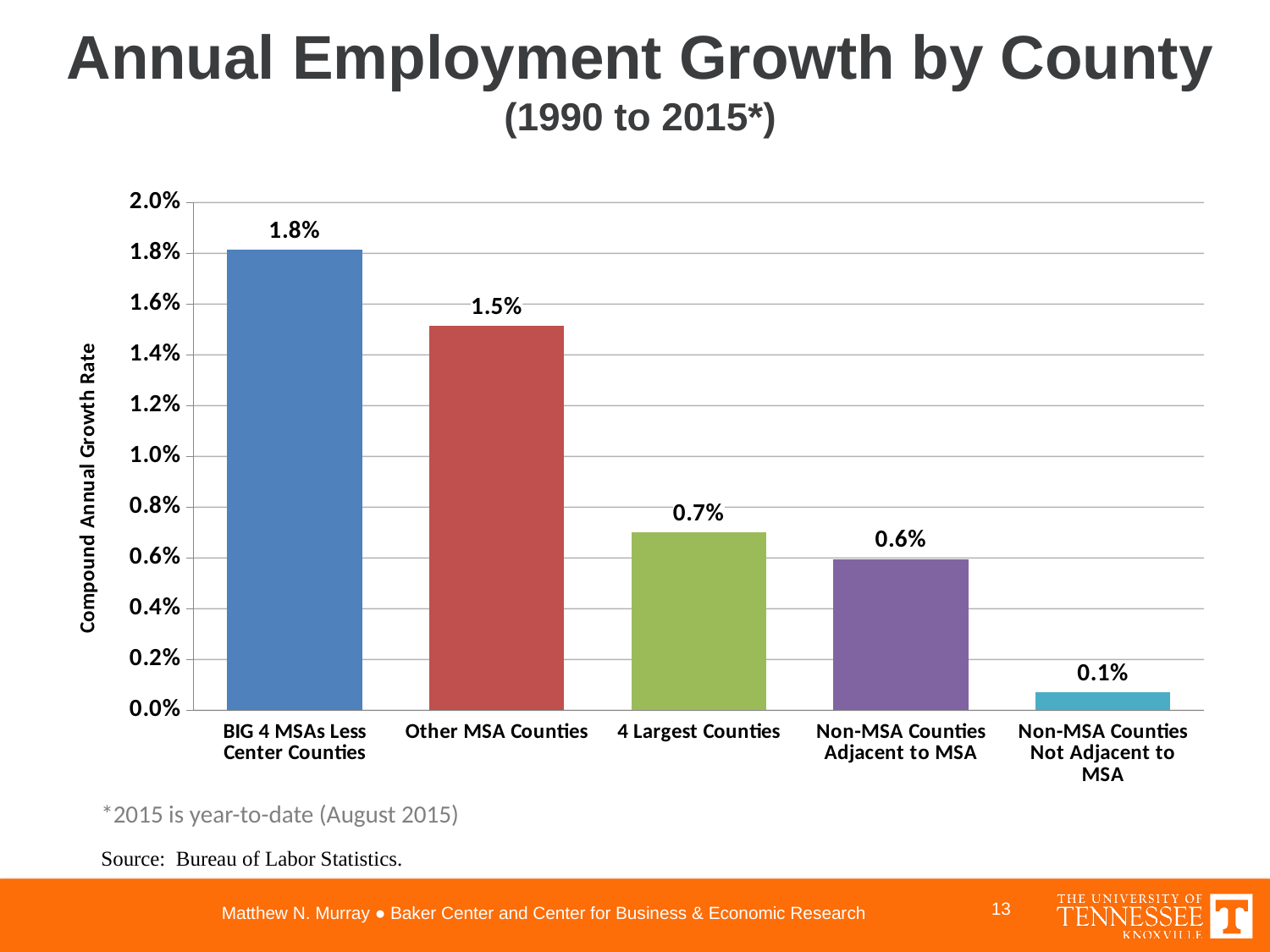
Do the values rise or fall moving from left to right across the categories? fall What is the compound annual growth rate for BIG 4 MSAs Less Center Counties? 1.8% Which category has the highest compound annual growth rate? BIG 4 MSAs Less Center Counties What kind of chart is shown on the slide? bar chart What is the label of the vertical axis? Compound Annual Growth Rate Which has a higher growth rate, 4 Largest Counties or Non-MSA Counties Adjacent to MSA? 4 Largest Counties What is the compound annual growth rate for Other MSA Counties? 1.5% What is the compound annual growth rate for Non-MSA Counties Not Adjacent to MSA? 0.1% How many county categories are shown in the chart? 5 What is the difference between the growth rates for BIG 4 MSAs Less Center Counties and 4 Largest Counties? 1.1% Is the value for Other MSA Counties greater or less than 1.0%? greater Which category has the lowest compound annual growth rate? Non-MSA Counties Not Adjacent to MSA